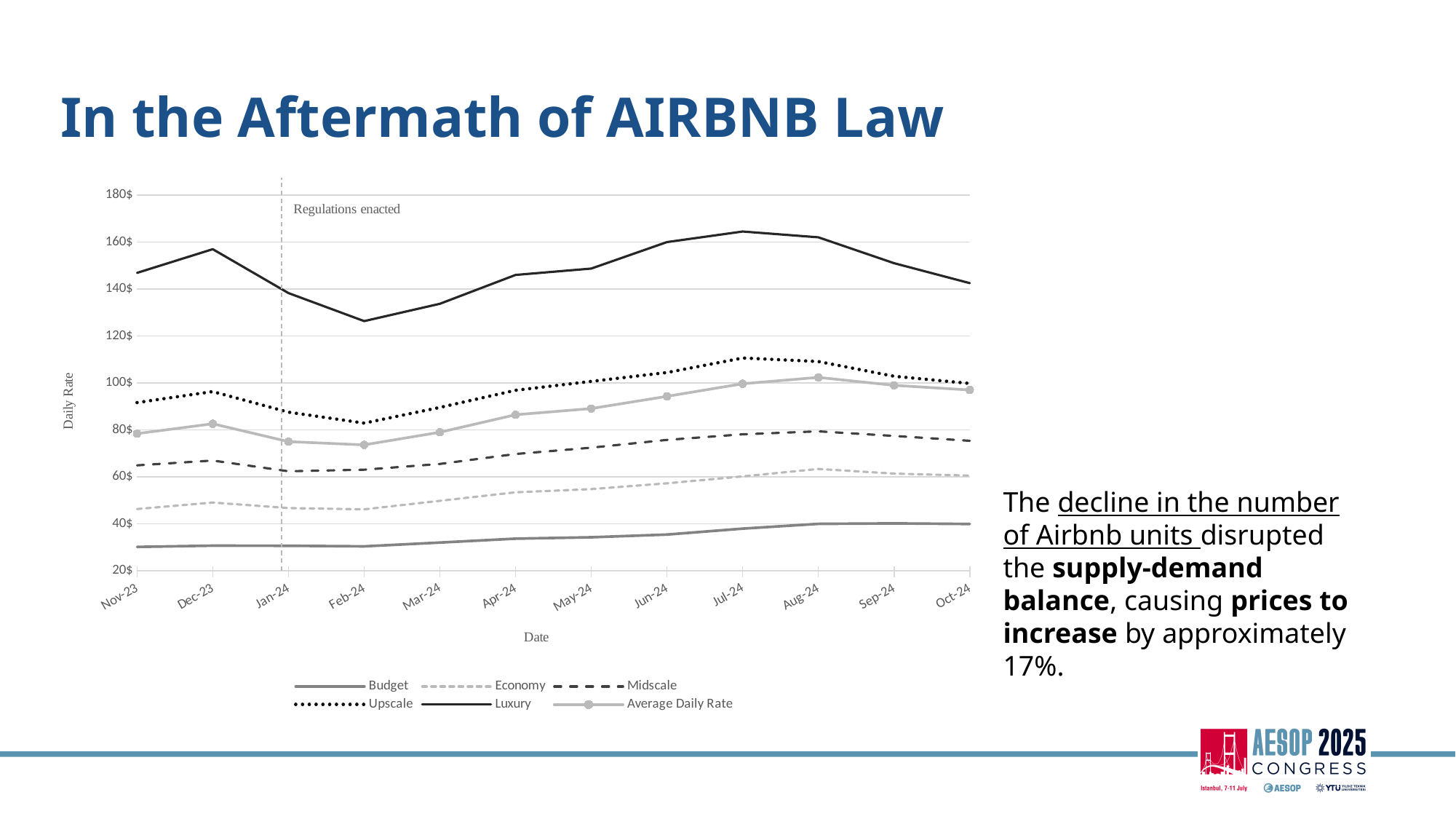
How many months are plotted along the x axis? 12 How many series does the legend list? 6 What does the dashed vertical line at Jan-24 mark, according to its label? Regulations enacted Is the Budget value for Nov-23 greater or less than 40$? less Does the Luxury series rise or fall from Feb-24 to Jul-24? rise In which month does the Luxury series reach its highest value? Jul-24 Is the Luxury value for Jul-24 greater or less than 160$? greater What kind of chart is shown on the slide? line chart Is the Luxury value for Feb-24 greater or less than 140$? less Which series has the highest daily rate across the whole period? Luxury In which month does the Luxury series reach its lowest value? Feb-24 Which is larger in Jul-24, the Luxury value or the Upscale value? Luxury